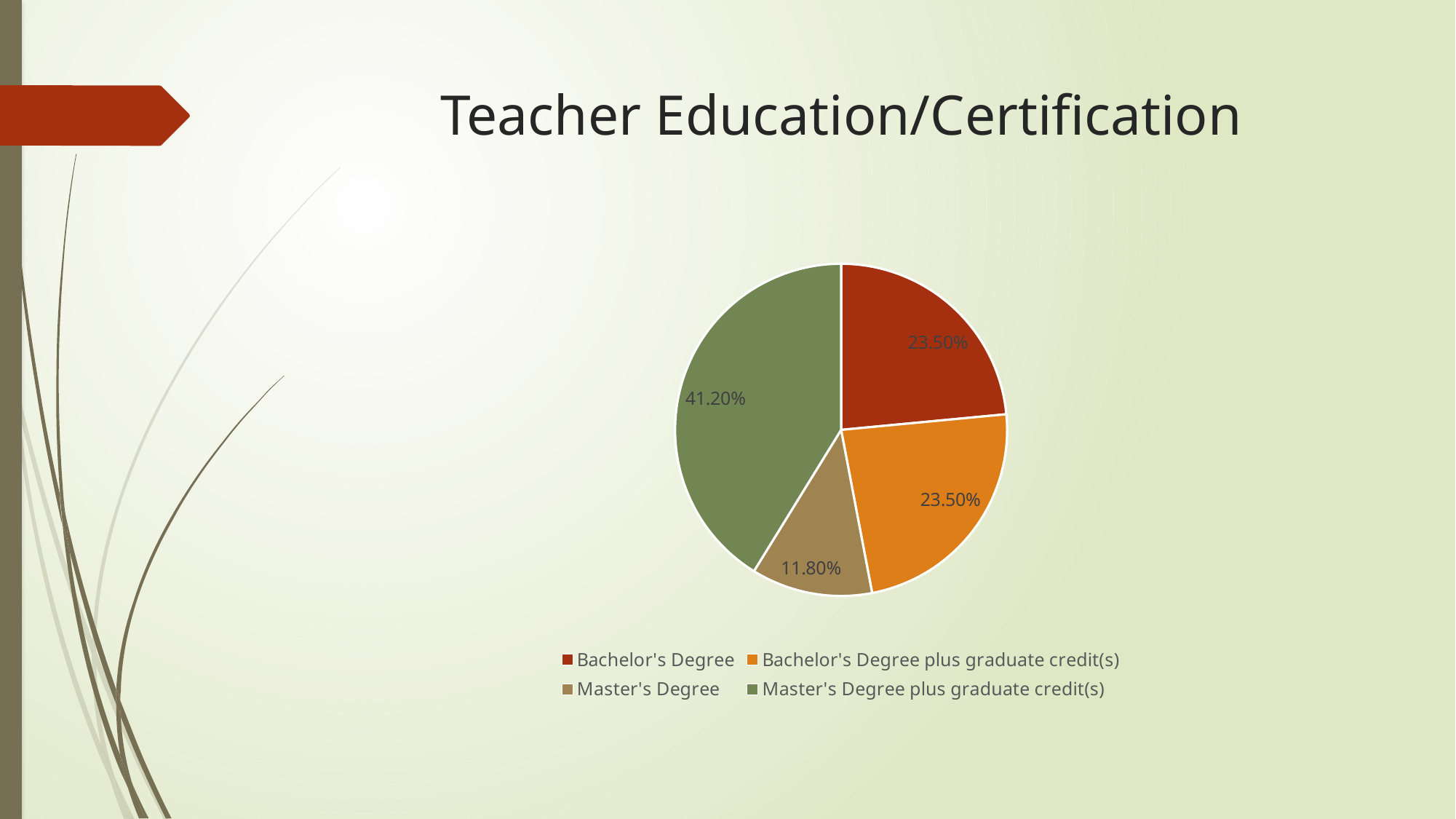
How many categories does the pie chart show? 4 Which category has the largest slice of the pie? Master's Degree plus graduate credit(s) Which is larger: the share for Master's Degree plus graduate credit(s) or the share for Bachelor's Degree? Master's Degree plus graduate credit(s) What share of the pie is Bachelor's Degree plus graduate credit(s)? 23.50% What share of the pie is Master's Degree? 11.80% What share of the pie is Master's Degree plus graduate credit(s)? 41.20% What kind of chart is shown on the slide? pie chart What is the title of the slide containing the chart? Teacher Education/Certification What share of the pie is Bachelor's Degree? 23.50% Which category has the smallest slice of the pie? Master's Degree What colour is the slice for Master's Degree plus graduate credit(s)? green What is the difference between the Master's Degree plus graduate credit(s) share and the Master's Degree share? 29.40%